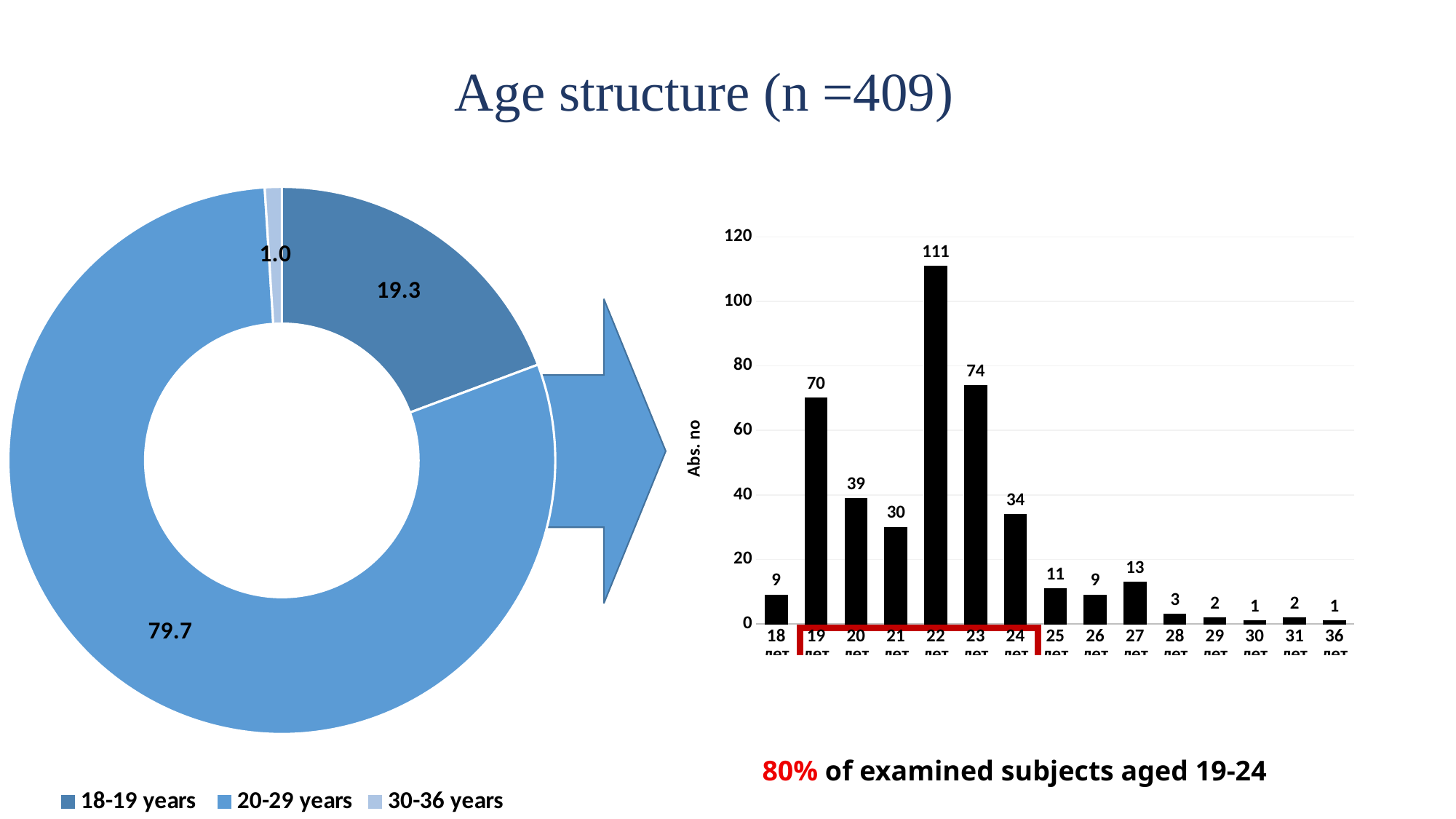
In the donut chart on the left, which age group has the smallest segment? 30-36 years In the donut chart on the left, what value is shown for the 18-19 years segment? 19.3 In the bar chart on the right, which is larger, the value for age 20 or the value for age 24? age 20 How many entries does the legend of the donut chart on the left list? 3 How many age categories are shown on the x axis of the bar chart on the right? 15 What is the y-axis label of the bar chart on the right? Abs. no In the bar chart on the right, which age has the highest value? 22 In the bar chart on the right, what is the difference between the values for age 22 and age 23? 37 What kind of chart is the chart on the right? bar chart In the bar chart on the right, what is the value for age 19? 70 In the bar chart on the right, what is the value for age 22? 111 In the donut chart on the left, what value is shown for the 20-29 years segment? 79.7